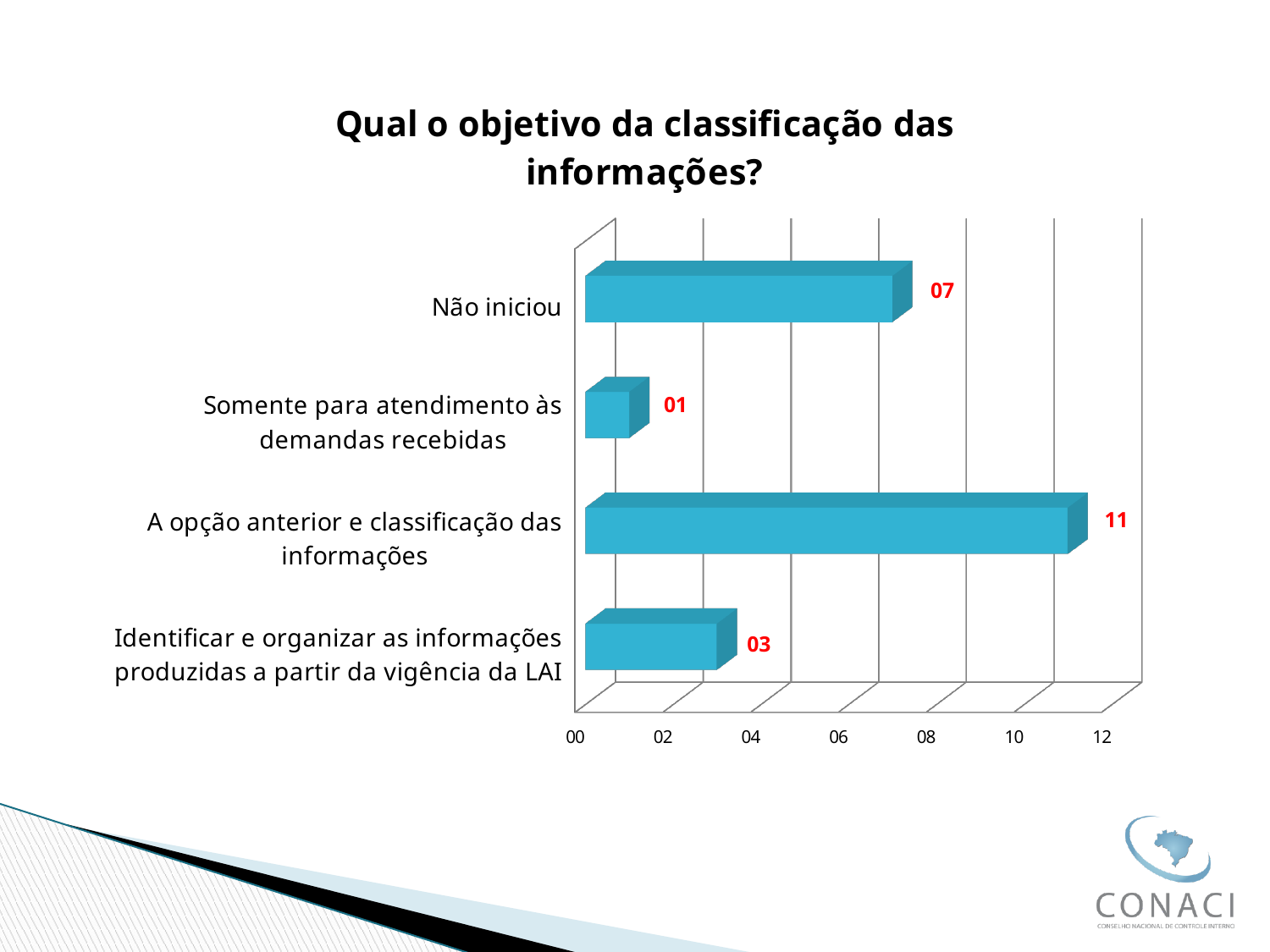
What kind of chart is shown on the slide? bar chart Is the value for "Não iniciou" greater or less than 06? greater Which category has the highest value? A opção anterior e classificação das informações What is the value for "Somente para atendimento às demandas recebidas"? 01 What is the value for "Identificar e organizar as informações produzidas a partir da vigência da LAI"? 03 How many categories are shown in the chart? 4 What is the difference between the values for "A opção anterior e classificação das informações" and "Não iniciou"? 04 Which category has the lowest value? Somente para atendimento às demandas recebidas What is the value for "A opção anterior e classificação das informações"? 11 What is the title of the chart? Qual o objetivo da classificação das informações? Which is larger: the value for "Não iniciou" or the value for "Identificar e organizar as informações produzidas a partir da vigência da LAI"? Não iniciou What is the value for "Não iniciou"? 07